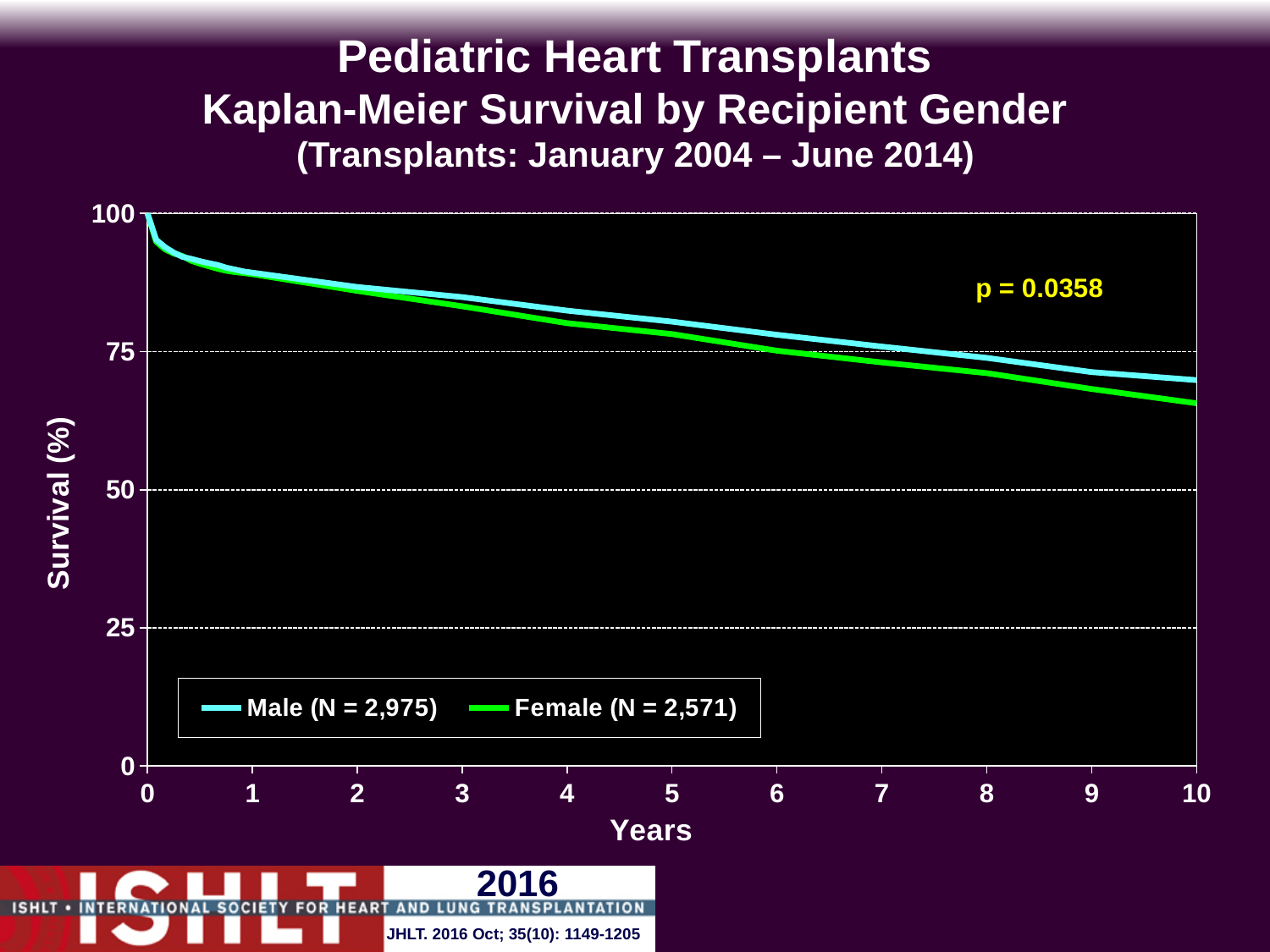
How many series does the legend list? 2 Is the Female survival value at 10 years greater or less than 75? less What is the maximum value shown on the x axis (Years)? 10 Is the Male survival value at 10 years greater or less than 50? greater Is the Male survival value at 3 years greater or less than 75? greater Do the survival curves rise or fall as the years increase? Fall What is the N for the Male group in the legend? 2,975 What kind of chart is shown on the slide? Line chart What is the p-value shown on the chart? p = 0.0358 At 10 years, which group has the higher survival, Male or Female? Male